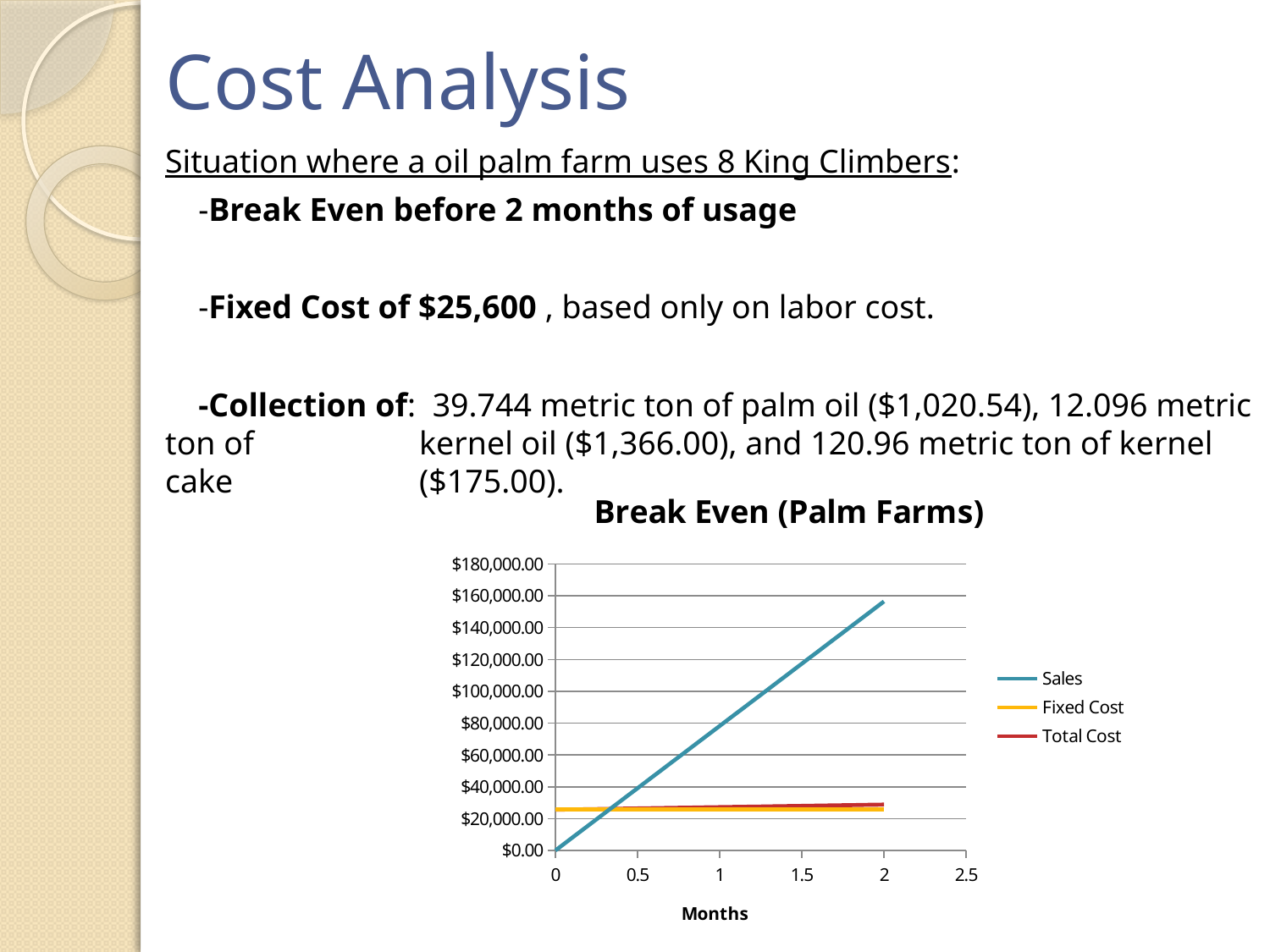
In the Break Even (Palm Farms) chart, at 2 months, which is larger: Sales or Total Cost? Sales In the Break Even (Palm Farms) chart, is the Fixed Cost line greater or less than $40,000.00? less What is the label of the x axis of the Break Even (Palm Farms) chart? Months In the Break Even (Palm Farms) chart, which series has the highest value at 2 months? Sales In the Break Even (Palm Farms) chart, is the Sales value at 1 month greater or less than $60,000.00? greater In the Break Even (Palm Farms) chart, which series has the lowest value at 0 months? Sales How many series does the legend of the Break Even (Palm Farms) chart list? 3 In the Break Even (Palm Farms) chart, at 0 months, which is larger: Fixed Cost or Sales? Fixed Cost What is the title of the chart on the slide? Break Even (Palm Farms) In the Break Even (Palm Farms) chart, does the Sales line rise or fall as months increase? rise In the Break Even (Palm Farms) chart, is the Sales value at 2 months greater or less than $140,000.00? greater What kind of chart is shown under the title "Break Even (Palm Farms)"? line chart